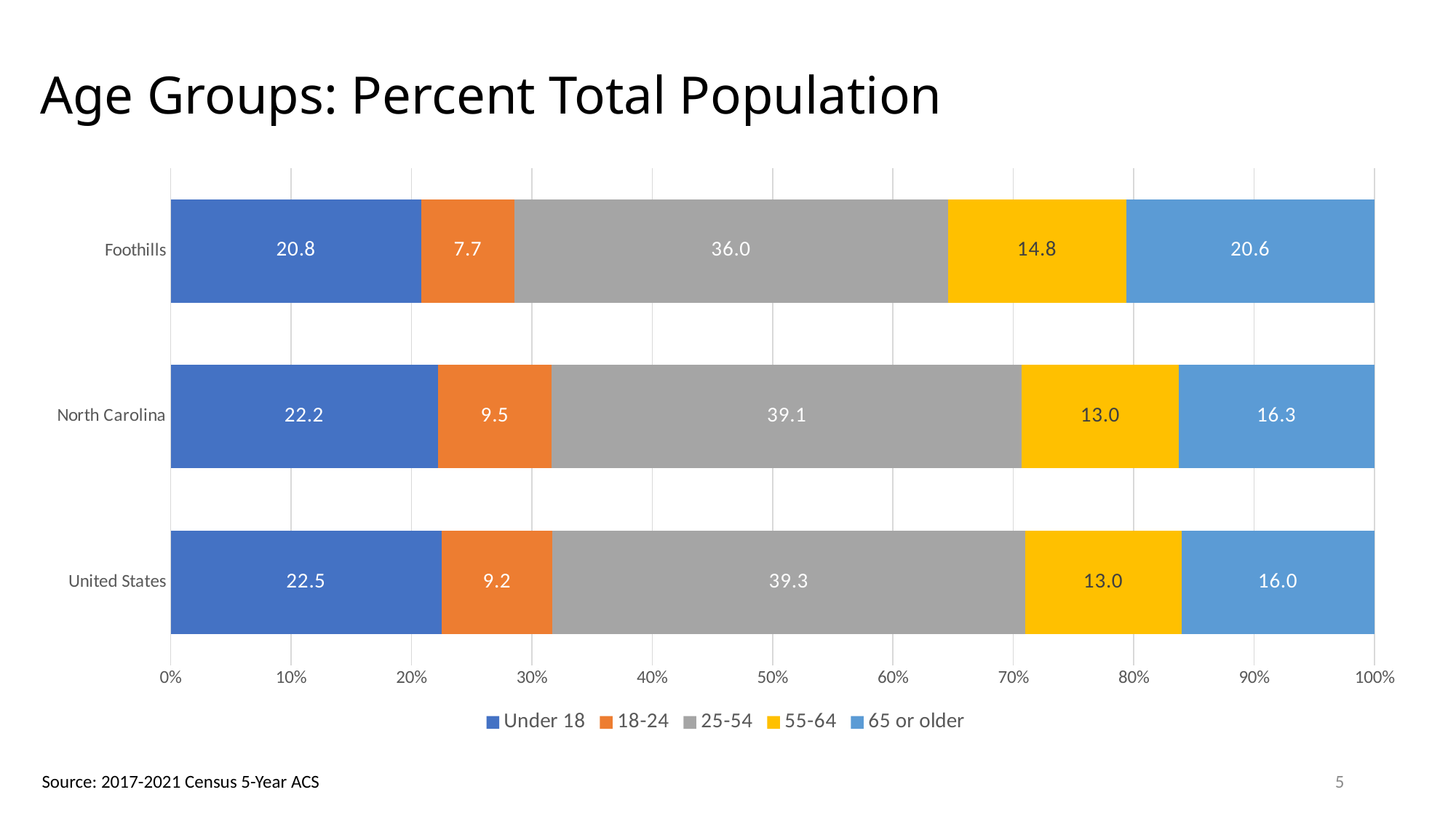
What kind of chart is shown on the slide? Stacked bar chart Which region has the highest value for the 65 or older age group? Foothills What is the value for the 18-24 age group in the United States? 9.2 Which is larger, the 55-64 value for Foothills or for North Carolina? Foothills What is the difference between the Under 18 values for the United States and Foothills? 1.7 What is the value for the 25-54 age group in Foothills? 36.0 Which region has the lowest value for the 18-24 age group? Foothills What is the value for the 65 or older age group in North Carolina? 16.3 How many regions are shown on the chart? 3 What is the title of the chart? Age Groups: Percent Total Population How many age groups does the legend list? 5 What is the total of the stacked bar for North Carolina? 100.1